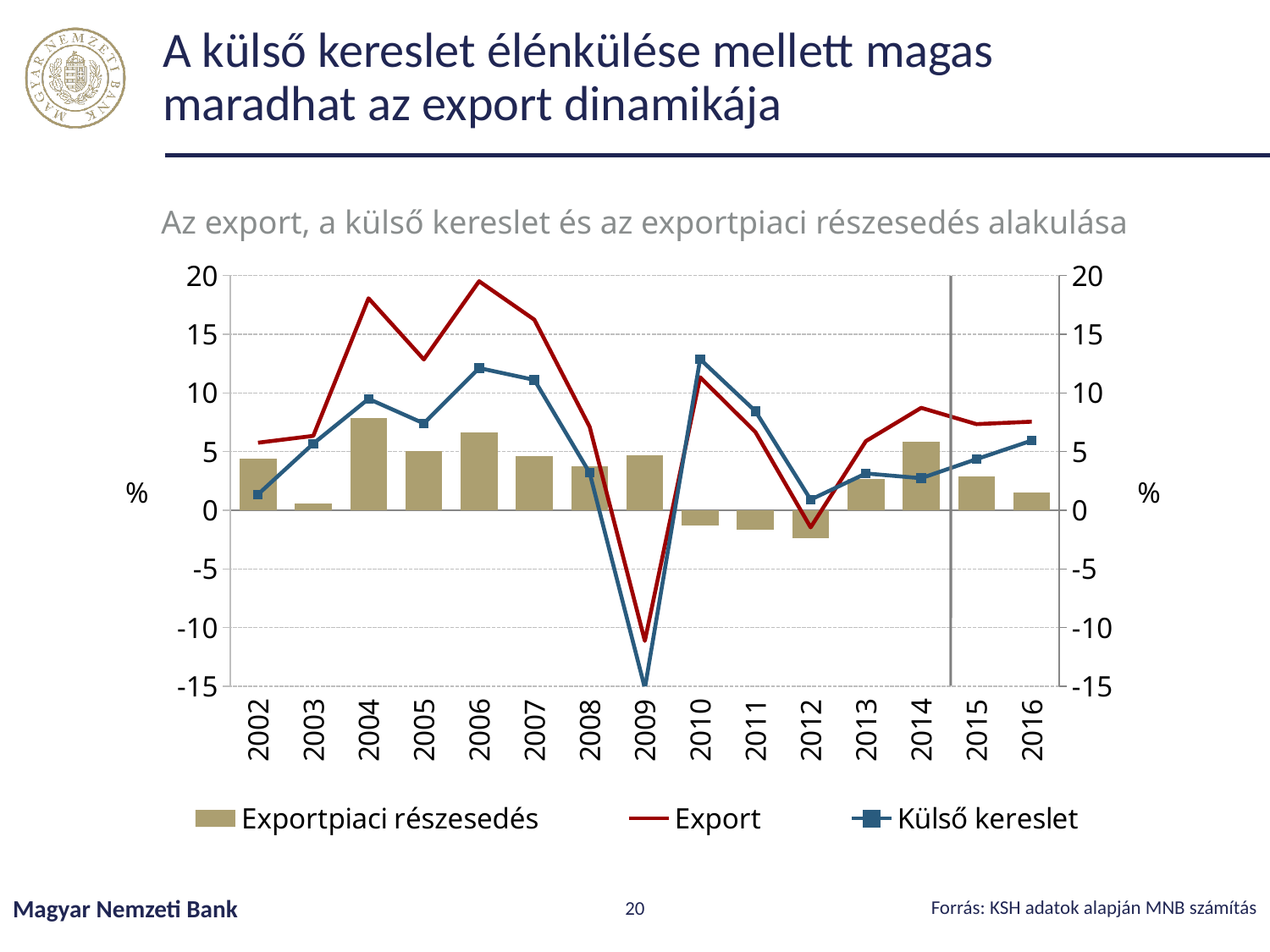
How many years are shown on the x axis? 15 How many series does the legend list? 3 In which year does the Export series reach its highest value? 2006 In which year is the Exportpiaci részesedés bar the lowest? 2012 In 2004, which is larger: the Export value or the Külső kereslet value? Export Is the Export value for 2004 greater or less than 15? greater In which year is the Exportpiaci részesedés bar the tallest? 2004 In which year is the Külső kereslet series at its lowest? 2009 What kind of chart is shown on the slide? A combined bar and line chart Does the Export series rise or fall between 2006 and 2009? Fall Is the Külső kereslet value for 2009 greater or less than -10? less In which year does the Export series reach its lowest value? 2009